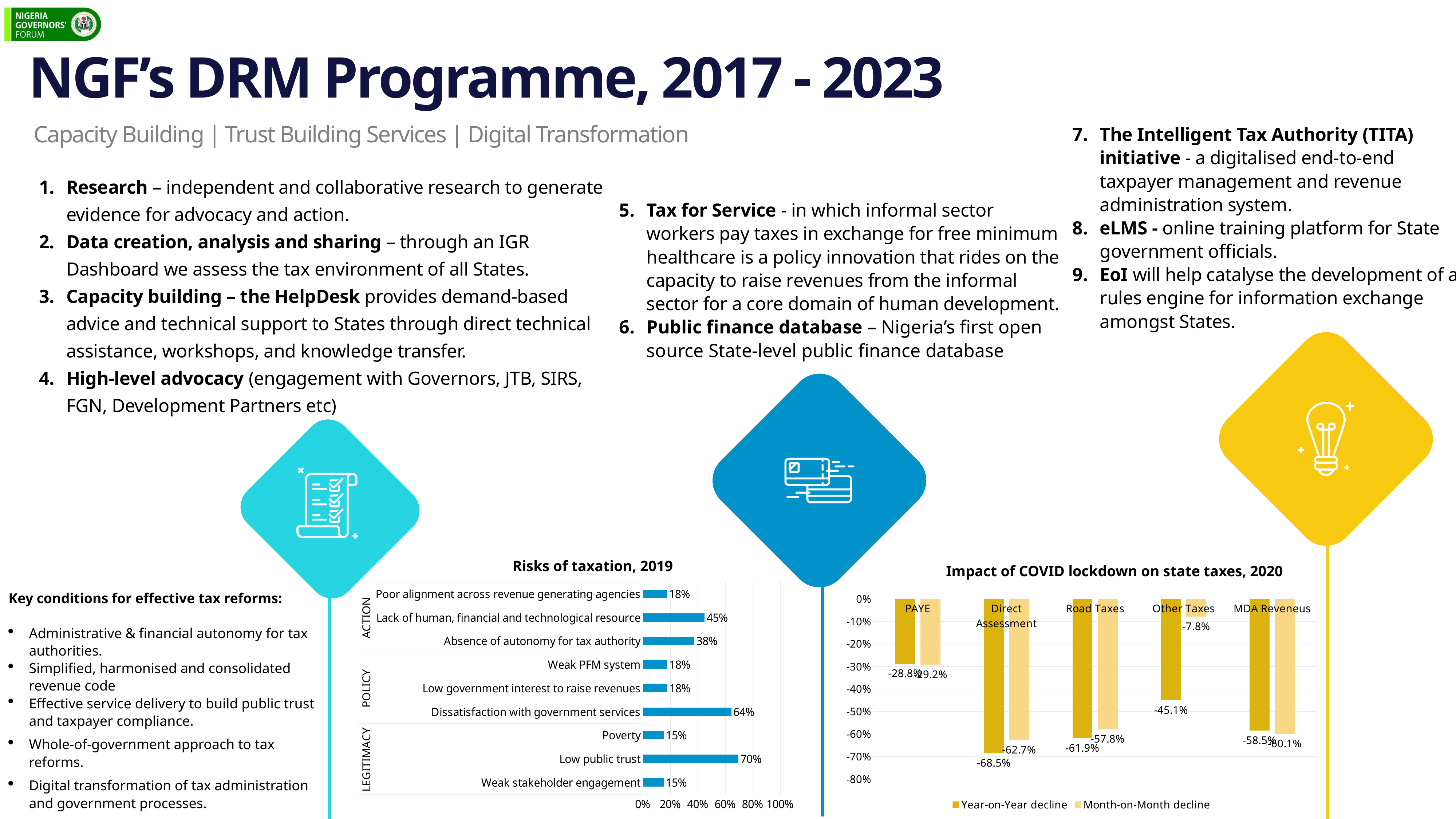
In the 'Risks of taxation, 2019' chart, how many categories are plotted? 9 In the 'Impact of COVID lockdown on state taxes, 2020' chart, how many series does the legend list? 2 In the 'Risks of taxation, 2019' chart, what is the difference between Dissatisfaction with government services and Absence of autonomy for tax authority? 26% In the 'Impact of COVID lockdown on state taxes, 2020' chart, what is the Year-on-Year decline for Direct Assessment? -68.5% In the 'Impact of COVID lockdown on state taxes, 2020' chart, what is the difference between the Year-on-Year decline and the Month-on-Month decline for MDA Revenues? 1.6% In the 'Risks of taxation, 2019' chart, what is the value for Lack of human, financial and technological resource? 45% In the 'Impact of COVID lockdown on state taxes, 2020' chart, what is the Month-on-Month decline for Other Taxes? -7.8% In the 'Impact of COVID lockdown on state taxes, 2020' chart, which is larger in magnitude: the Year-on-Year decline for Road Taxes or the Year-on-Year decline for Other Taxes? Road Taxes What kind of chart is 'Risks of taxation, 2019'? Bar chart In the 'Risks of taxation, 2019' chart, what is the value for Low public trust? 70% In the 'Risks of taxation, 2019' chart, which category has the highest value? Low public trust In the 'Impact of COVID lockdown on state taxes, 2020' chart, how many tax categories are shown? 5